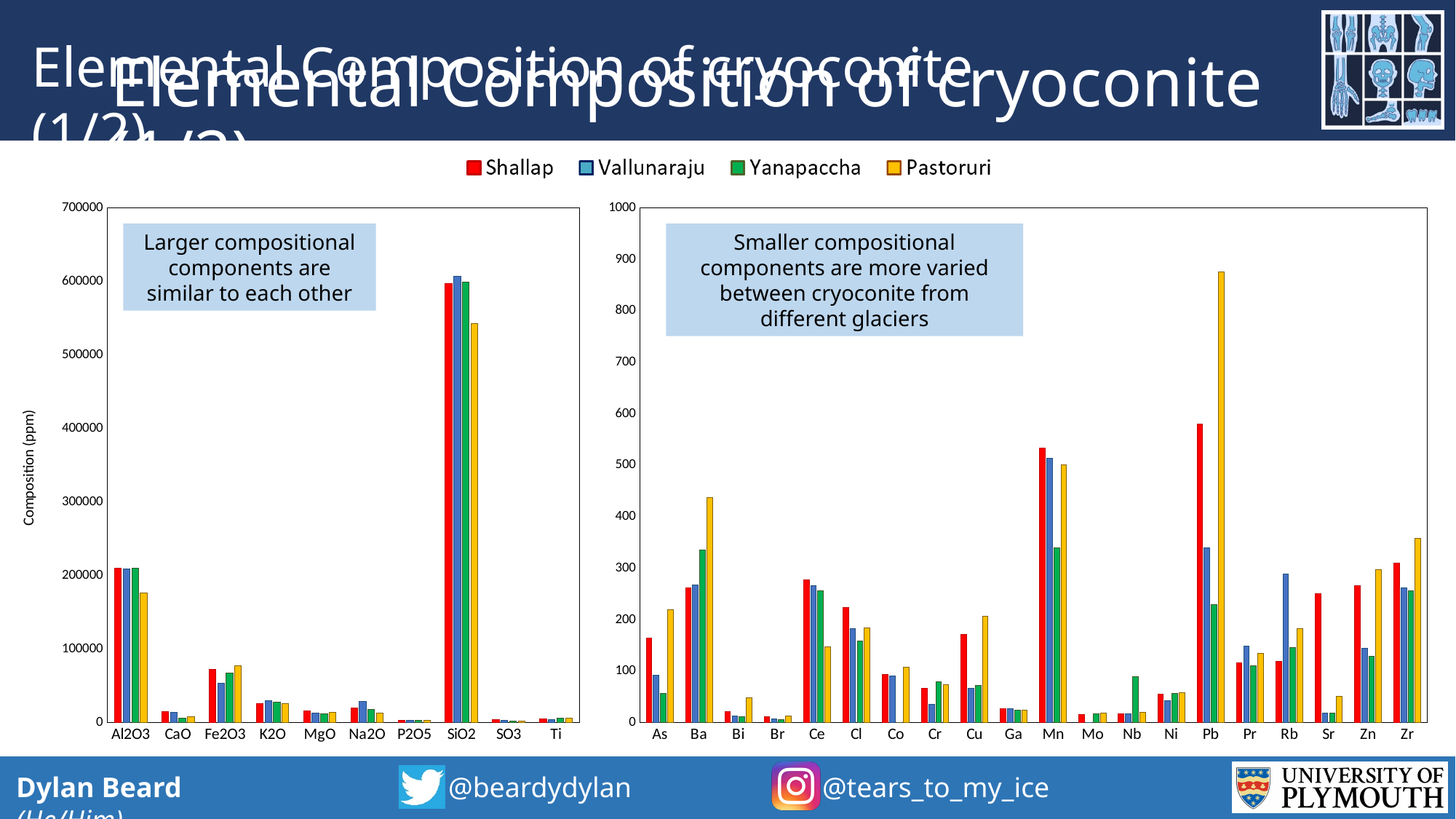
In the right chart, which is larger for Rb: the Vallunaraju value or the Yanapaccha value? Vallunaraju How many categories are shown on the x axis of the left chart? 10 In the right chart, which series has the tallest bar for Pb? Pastoruri In the right chart, is the Shallap value for Mn greater or less than 500? greater In the left chart, which category has the highest values? SiO2 In the left chart, is the Pastoruri value for SiO2 greater or less than 600000? less How many categories are shown on the x axis of the right chart? 20 In the right chart, which is larger for Ba: the Shallap value or the Pastoruri value? Pastoruri What is the label on the y axis of the left chart? Composition (ppm) What kind of chart is the left chart on the slide? bar chart How many series does the legend list? 4 In the right chart, is the Pastoruri value for Pb greater or less than 800? greater